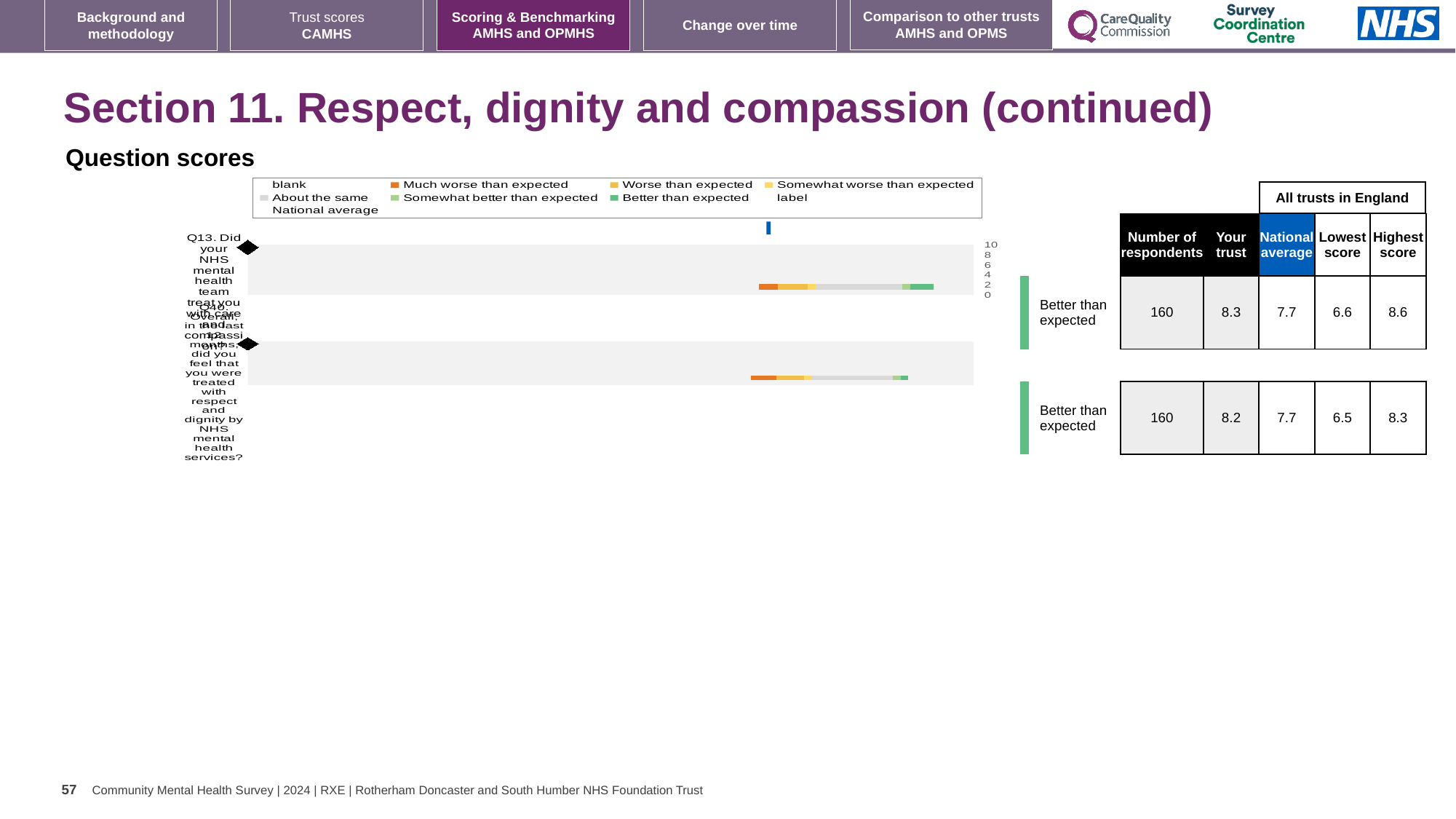
What is the lowest score across all trusts in England for Q13? 6.6 What kind of chart is shown under 'Question scores'? bar chart What is the 'Your trust' score for Q10 (treated with respect and dignity)? 8.2 How many respondents answered Q10? 160 What is the national average score for Q13? 7.7 What is the difference between the highest and lowest scores across all trusts for Q10? 1.8 What is the difference between the 'Your trust' score and the national average for Q13? 0.6 Which question has the higher 'Your trust' score, Q13 or Q10? Q13 What benchmark category is shown for Q13 and Q10? Better than expected What is the highest score across all trusts in England for Q10? 8.3 How many questions are plotted in the chart? 2 What is the 'Your trust' score for Q13 (treated with care and compassion)? 8.3